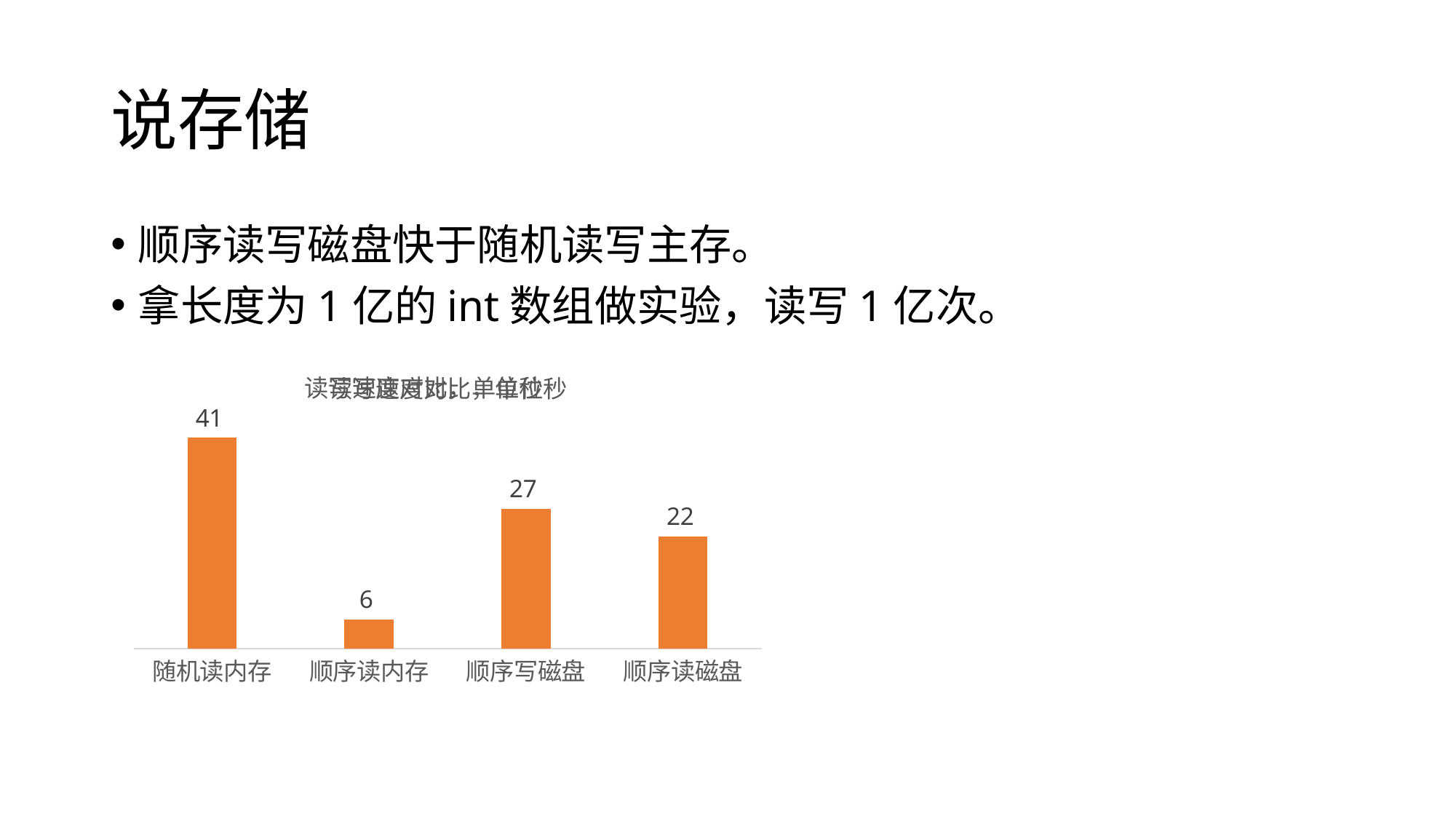
Which is larger, the value for 顺序写磁盘 or the value for 顺序读磁盘? 顺序写磁盘 Which category has the highest value? 随机读内存 How many categories are shown in the chart? 4 What is the value for 顺序读磁盘? 22 What is the value for 顺序读内存? 6 What is the value for 随机读内存? 41 What is the difference between the values for 随机读内存 and 顺序读内存? 35 What colour are the bars in the chart? orange What is the difference between the values for 顺序写磁盘 and 顺序读磁盘? 5 Which category has the lowest value? 顺序读内存 What is the value for 顺序写磁盘? 27 What kind of chart is shown on the slide? bar chart